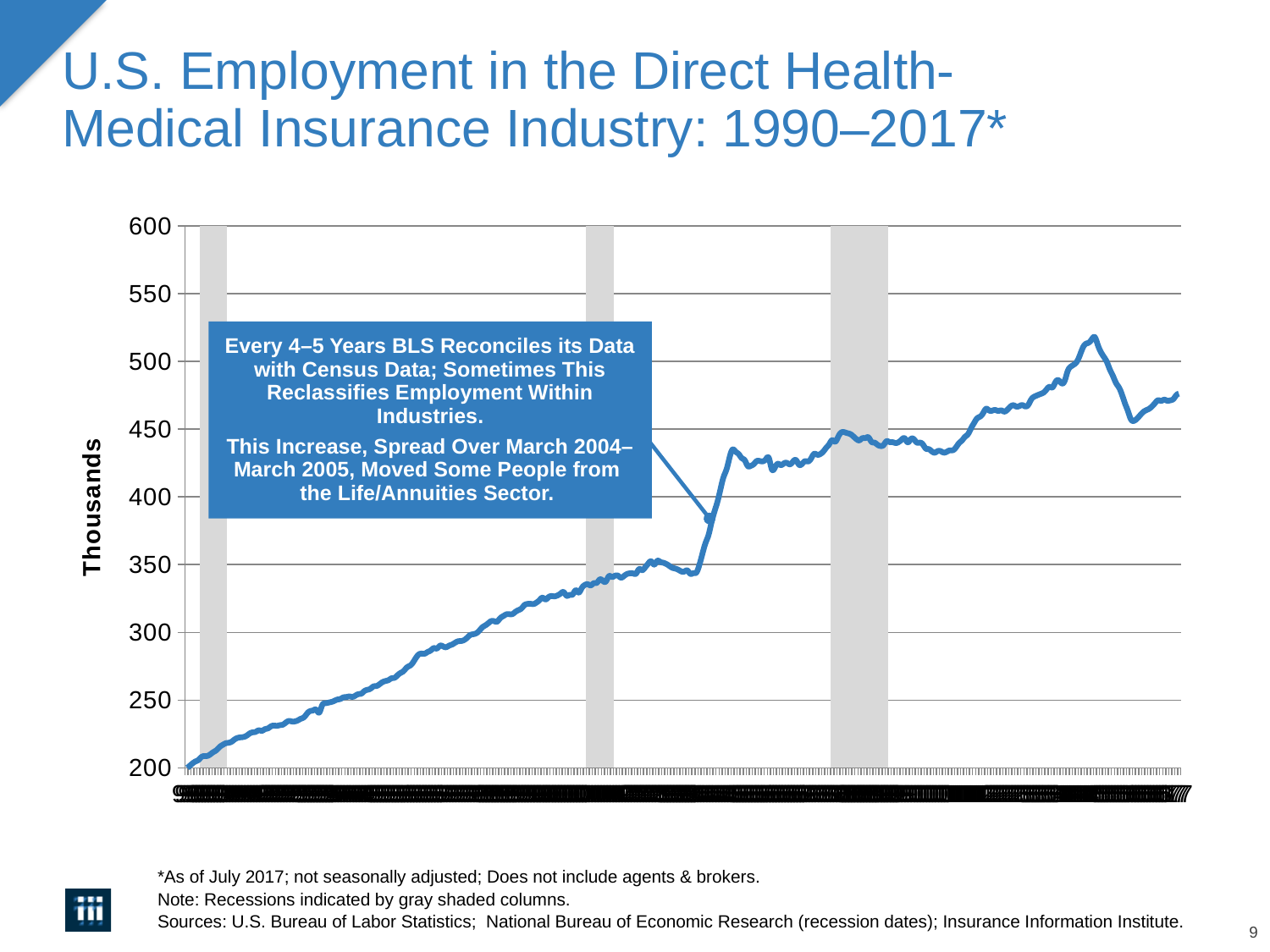
Is the highest point reached by the line greater or less than 500? greater Is the lowest point of the line greater or less than 250? less Is the value at the left-hand start of the line greater or less than 300? less How many gray shaded recession columns appear on the chart? 3 Overall, do the values on the line rise or fall from the left of the x axis to the right? rise What is the label on the vertical axis of the chart? Thousands What kind of chart is shown on the slide? line chart